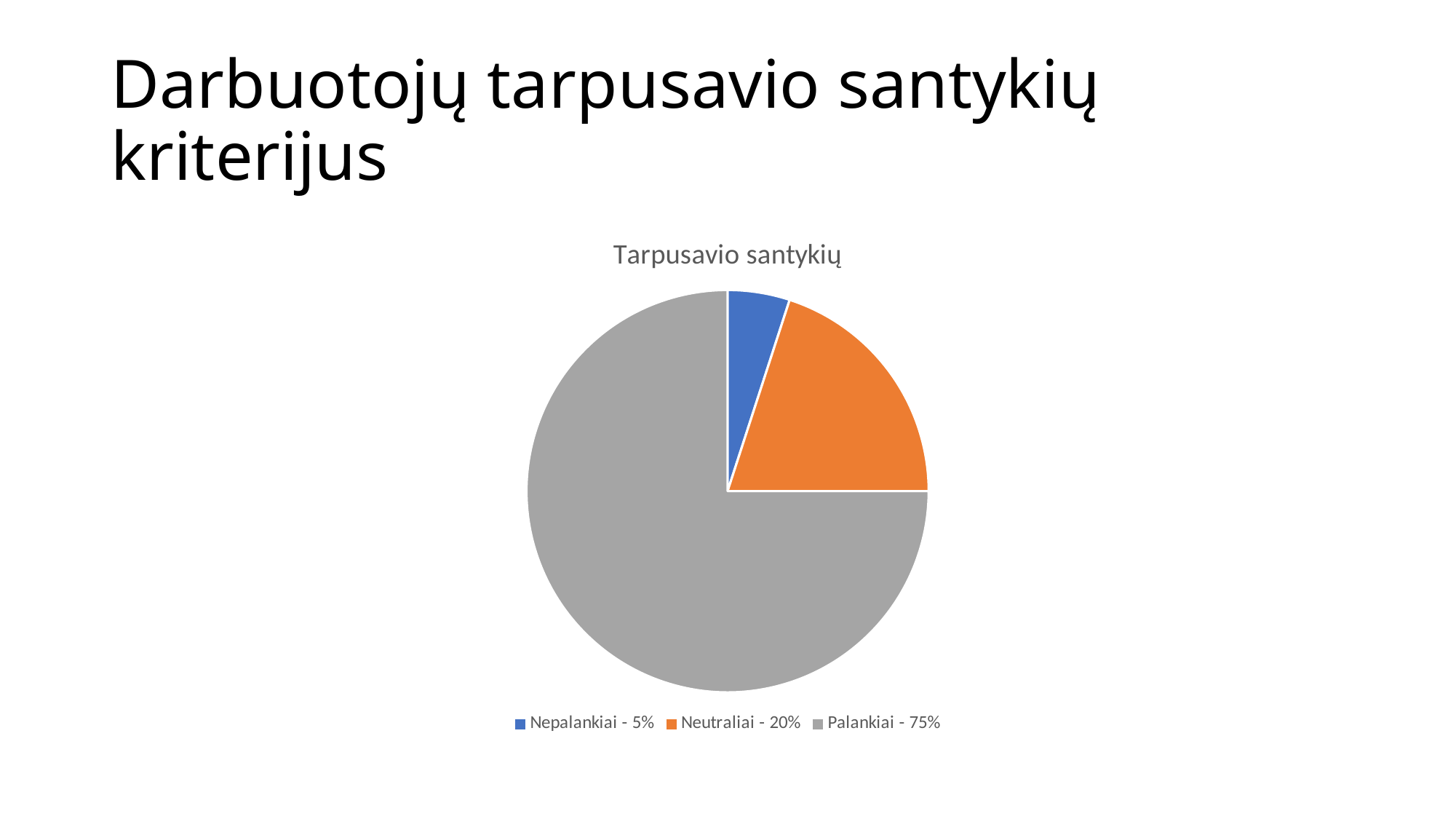
What kind of chart is shown on the slide? pie chart Which category has the largest slice of the pie? Palankiai What is the title of the chart? Tarpusavio santykių Which category has the smallest slice of the pie? Nepalankiai How many slices does the pie chart have? 3 What colour is the Palankiai slice? grey What share of the pie does Palankiai represent? 75% What is the difference between the shares of Neutraliai and Nepalankiai? 15% Which is larger, the share of Neutraliai or the share of Nepalankiai? Neutraliai What share of the pie does Nepalankiai represent? 5% What share of the pie does Neutraliai represent? 20% What is the difference between the shares of Palankiai and Neutraliai? 55%